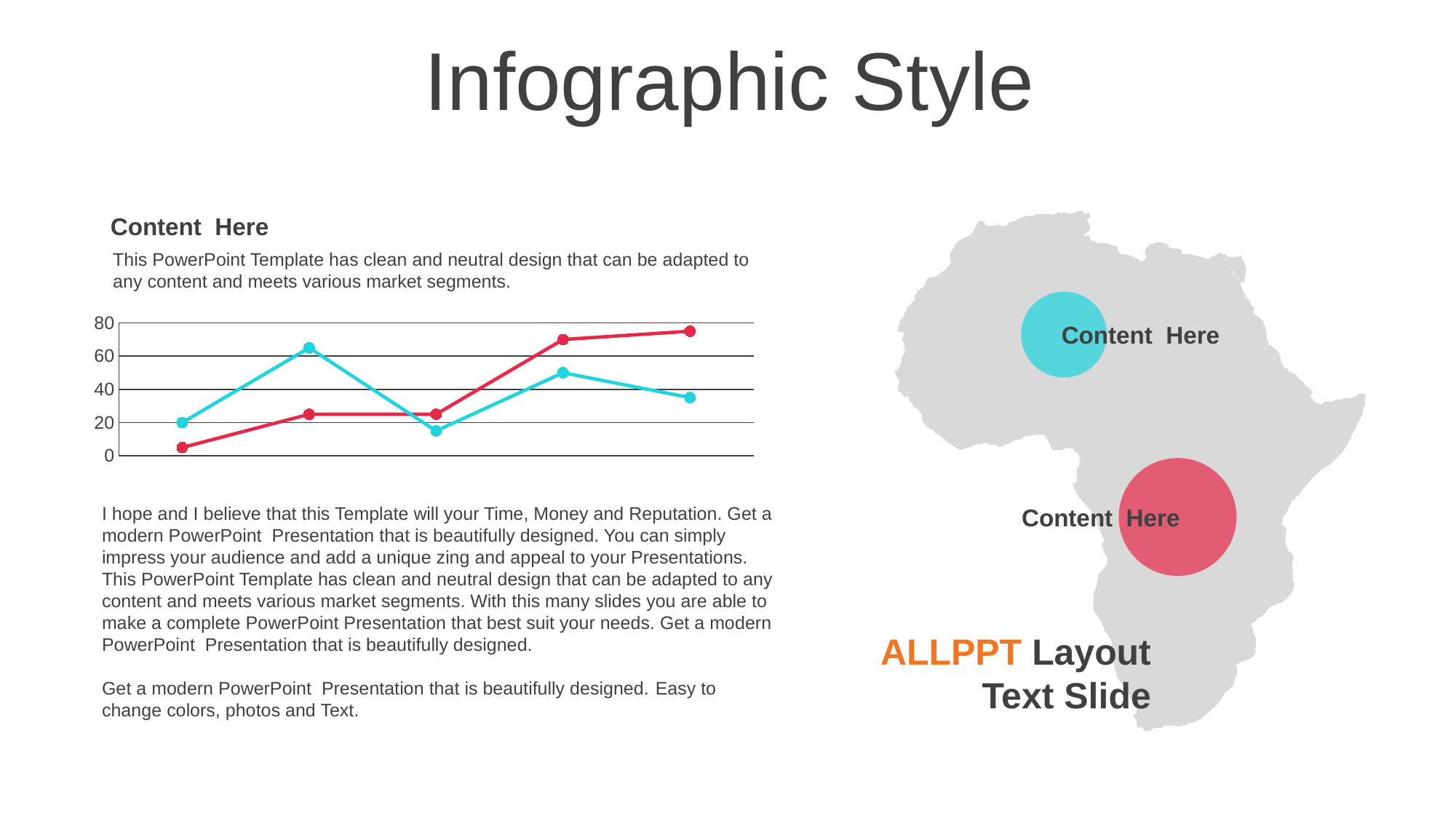
Which point on the red line has the lowest value? the first point How many lines are plotted in the chart? 2 At the last point, which line has the higher value, the red line or the cyan line? red line Is the value of the last point on the red line greater or less than 60? greater Which point on the cyan line has the highest value? the second point Is the value of the second point on the cyan line greater or less than 60? greater How many data points does each line in the chart have? 5 What kind of chart is shown on the slide? line chart Does the red line rise or fall between its fourth and fifth points? rise Is the value of the third point on the cyan line greater or less than 20? less At the second point, which line has the higher value, the red line or the cyan line? cyan line